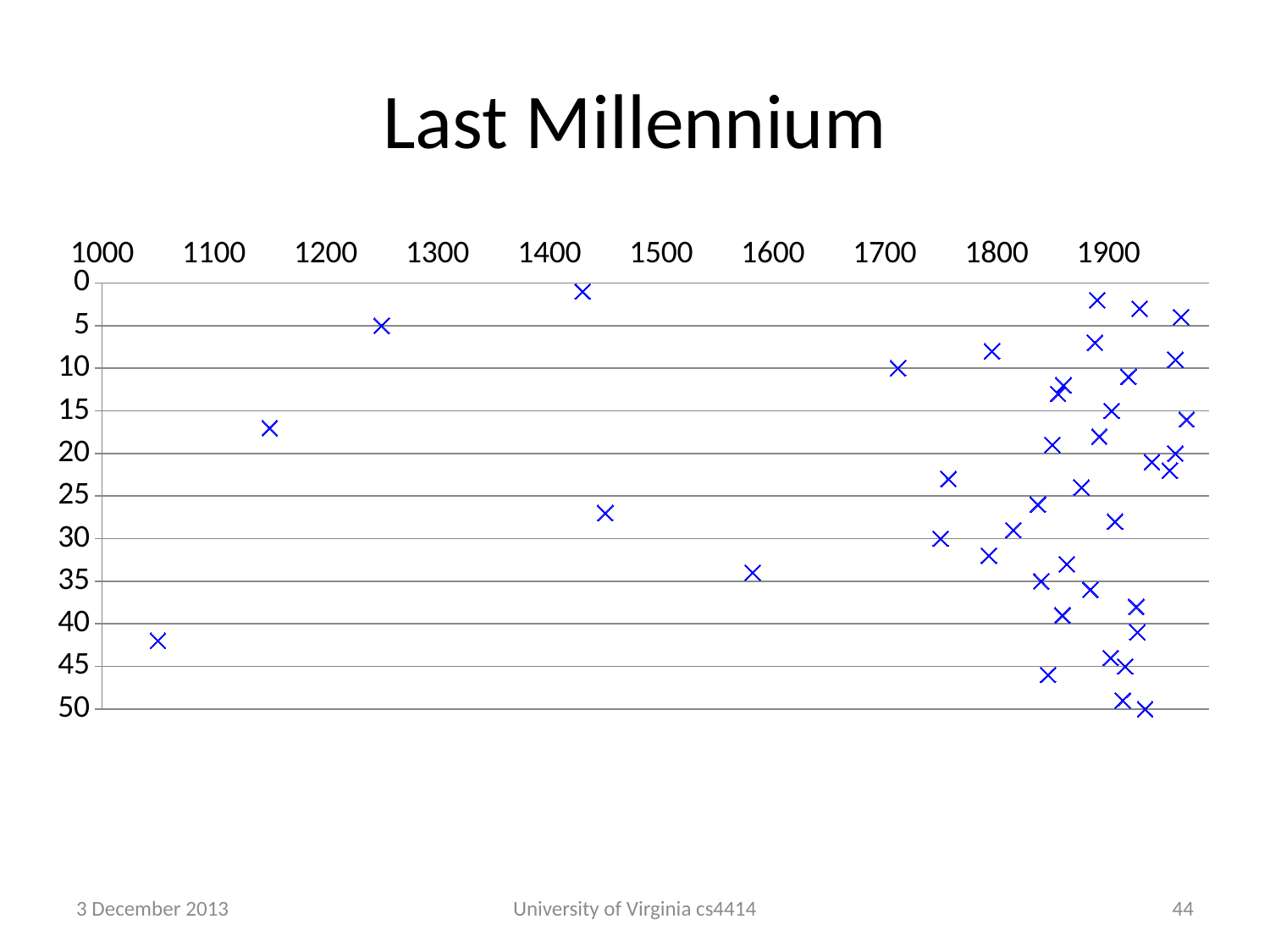
Is the y value of the point near x = 1710 greater or less than 20? less Is the y value of the point near x = 1430 greater or less than 5? less Is the y value of the point near x = 1150 greater or less than 10? greater What kind of chart is shown on the slide? scatter chart What is the title of the chart? Last Millennium What is the largest value labeled on the x axis of the chart? 1900